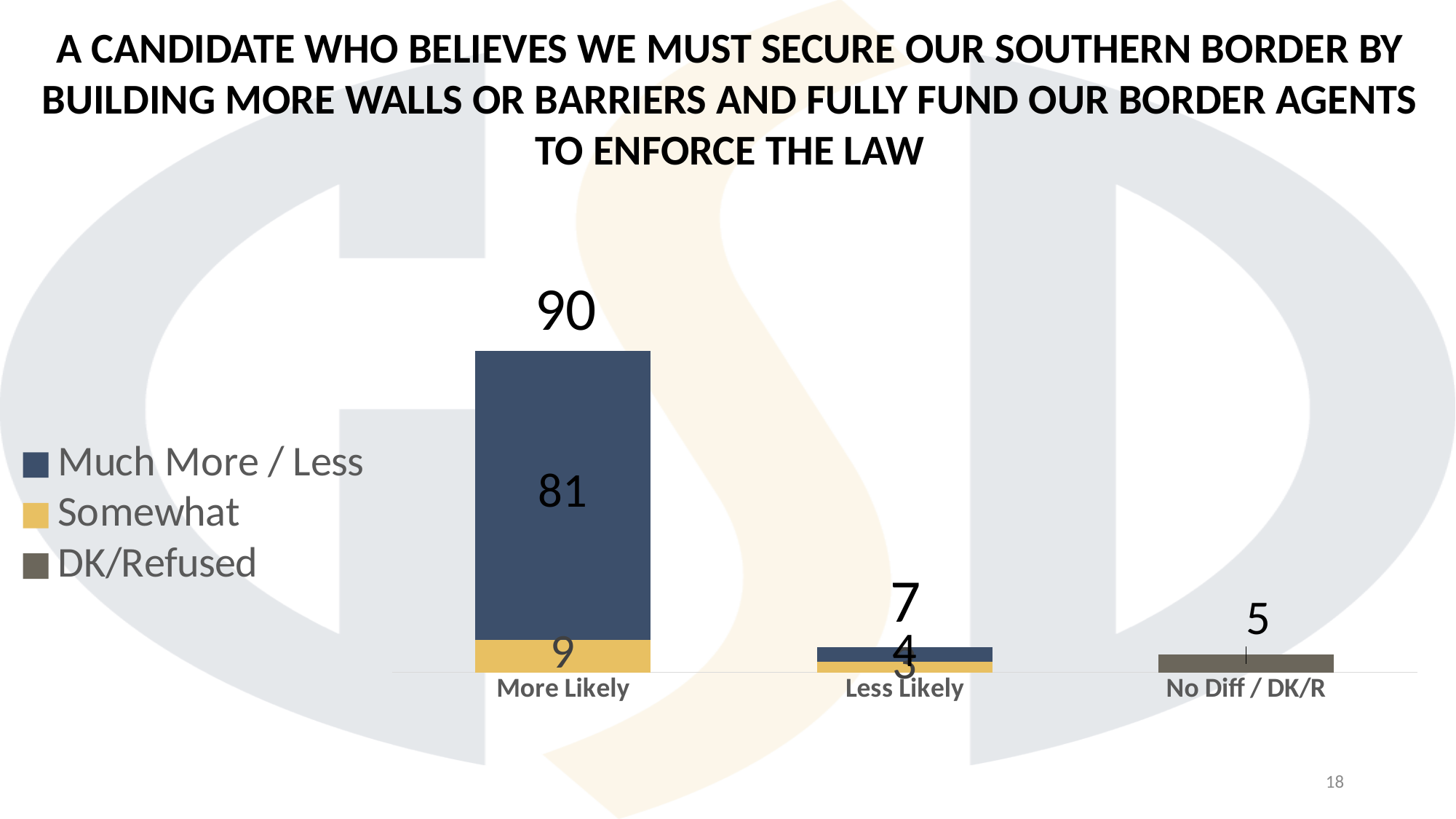
What is the Much More / Less value for More Likely? 81 How many series does the legend list? 3 What is the value for No Diff / DK/R? 5 Which category has the highest total? More Likely What is the total value of the More Likely bar? 90 What type of chart is shown on the slide? Stacked bar chart What is the Somewhat value for More Likely? 9 Which legend entry is shown in gold/yellow? Somewhat What is the difference between the More Likely total and the Less Likely total? 83 What is the Much More / Less value for Less Likely? 4 How many categories are shown on the x axis? 3 What is the total value of the Less Likely bar? 7